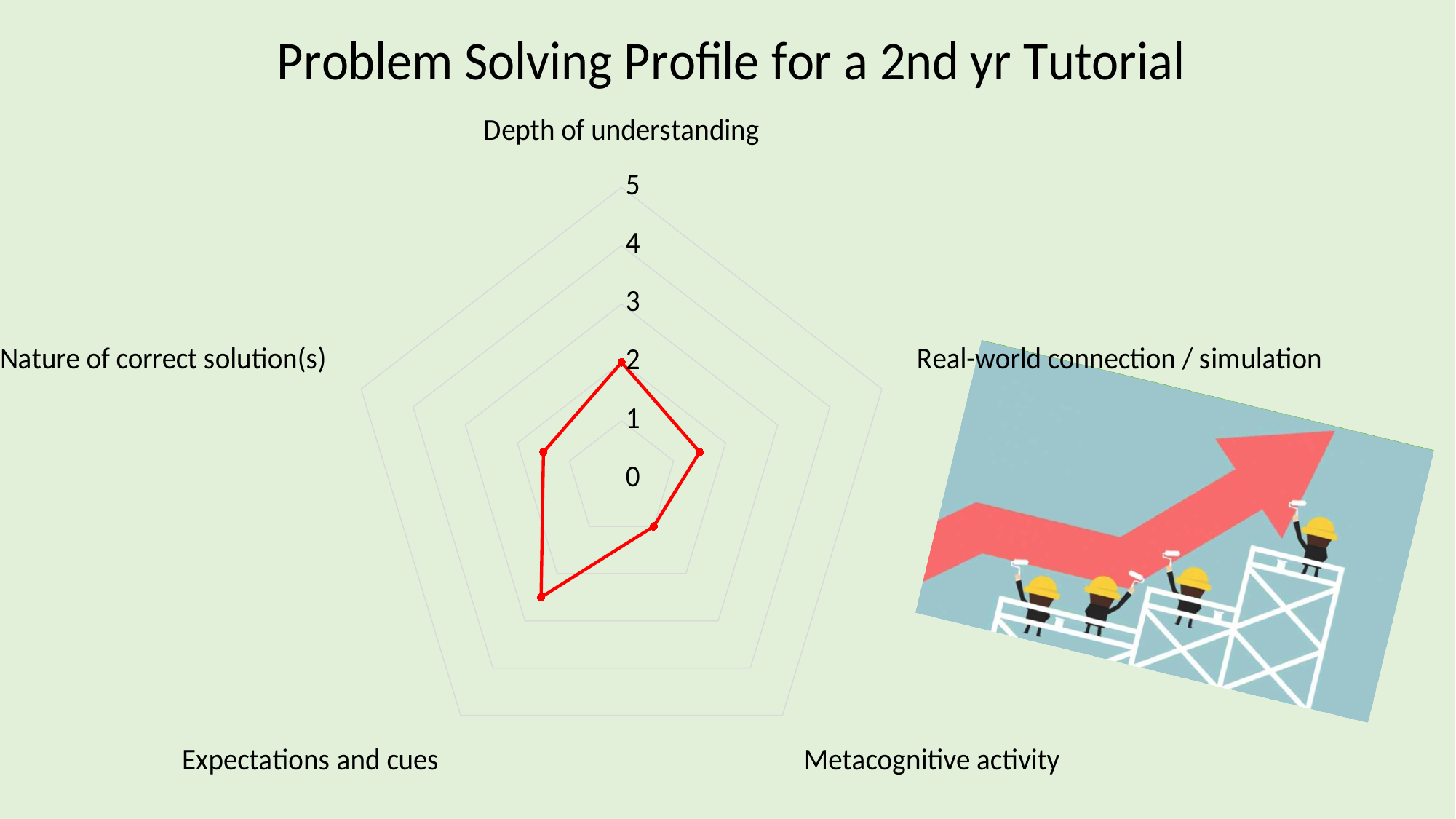
Which category has the highest value? Expectations and cues What is the maximum value shown on the chart's scale? 5 What kind of chart is shown on the slide? Radar chart Which category has the lowest value? Metacognitive activity Is the value for Expectations and cues greater or less than 2? greater Is the value for Real-world connection / simulation greater or less than 3? less What is the title of the chart? Problem Solving Profile for a 2nd yr Tutorial How many categories (axes) does the radar chart have? 5 Is the value for Nature of correct solution(s) greater or less than 3? less What is the value for Metacognitive activity? 1 What is the value for Depth of understanding? 2 Which is larger, the value for Expectations and cues or the value for Metacognitive activity? Expectations and cues